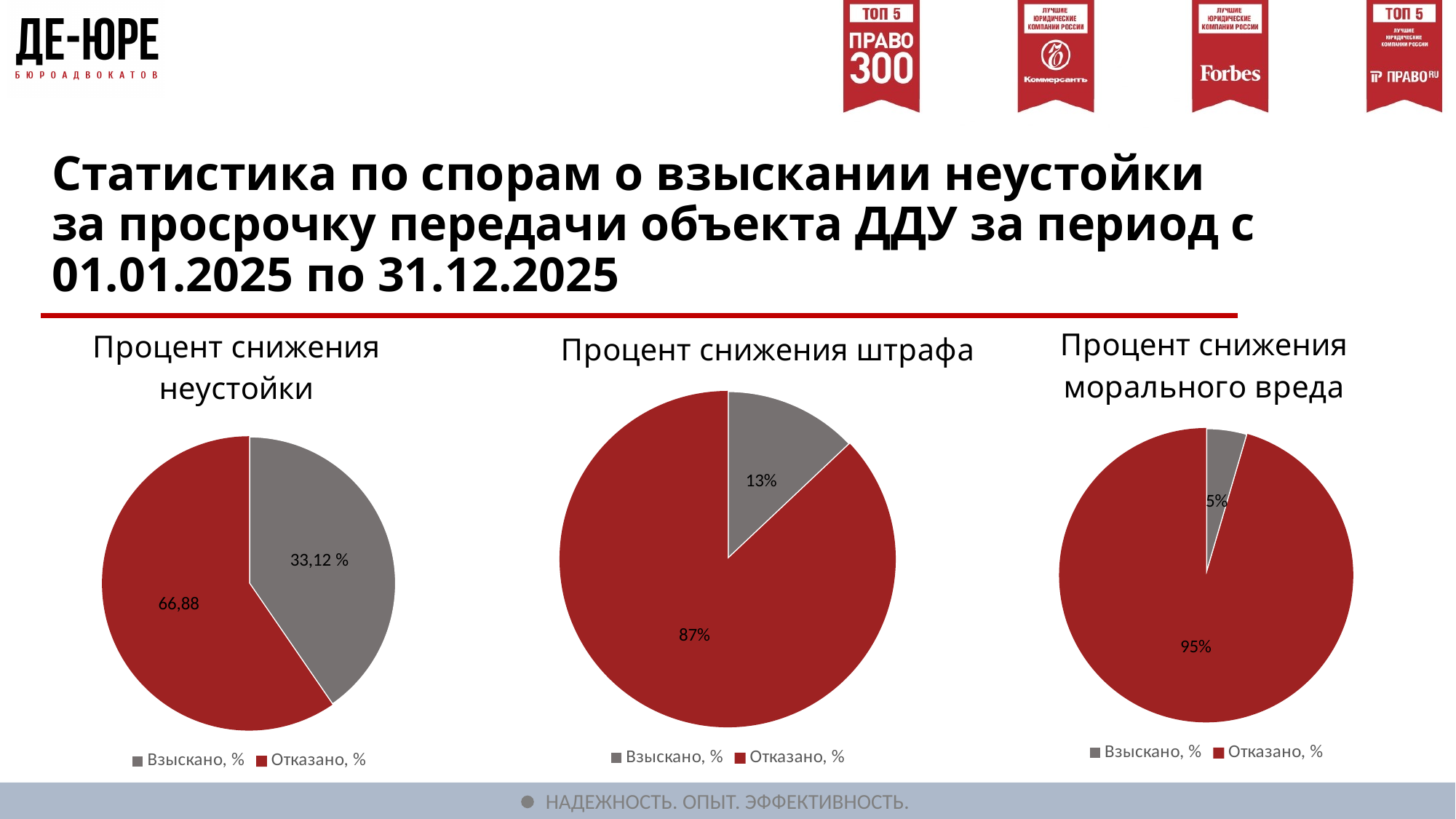
In the chart titled "Процент снижения неустойки", which is larger: "Взыскано, %" or "Отказано, %"? Отказано, % In the chart titled "Процент снижения неустойки", what value is shown for "Отказано, %"? 66,88 In the chart titled "Процент снижения морального вреда", what value is shown for "Отказано, %"? 95% In the chart titled "Процент снижения морального вреда", what value is shown for "Взыскано, %"? 5% In the chart titled "Процент снижения неустойки", what value is shown for "Взыскано, %"? 33,12 % How many entries does the legend of the chart titled "Процент снижения штрафа" list? 2 In the chart titled "Процент снижения штрафа", which slice is the largest? Отказано, % In the chart titled "Процент снижения штрафа", what is the difference between the "Отказано, %" and "Взыскано, %" values? 74% In the chart titled "Процент снижения морального вреда", which slice is the smallest? Взыскано, % In the chart titled "Процент снижения штрафа", what value is shown for "Взыскано, %"? 13% What type of chart is the chart titled "Процент снижения морального вреда"? Pie chart In the chart titled "Процент снижения штрафа", what value is shown for "Отказано, %"? 87%